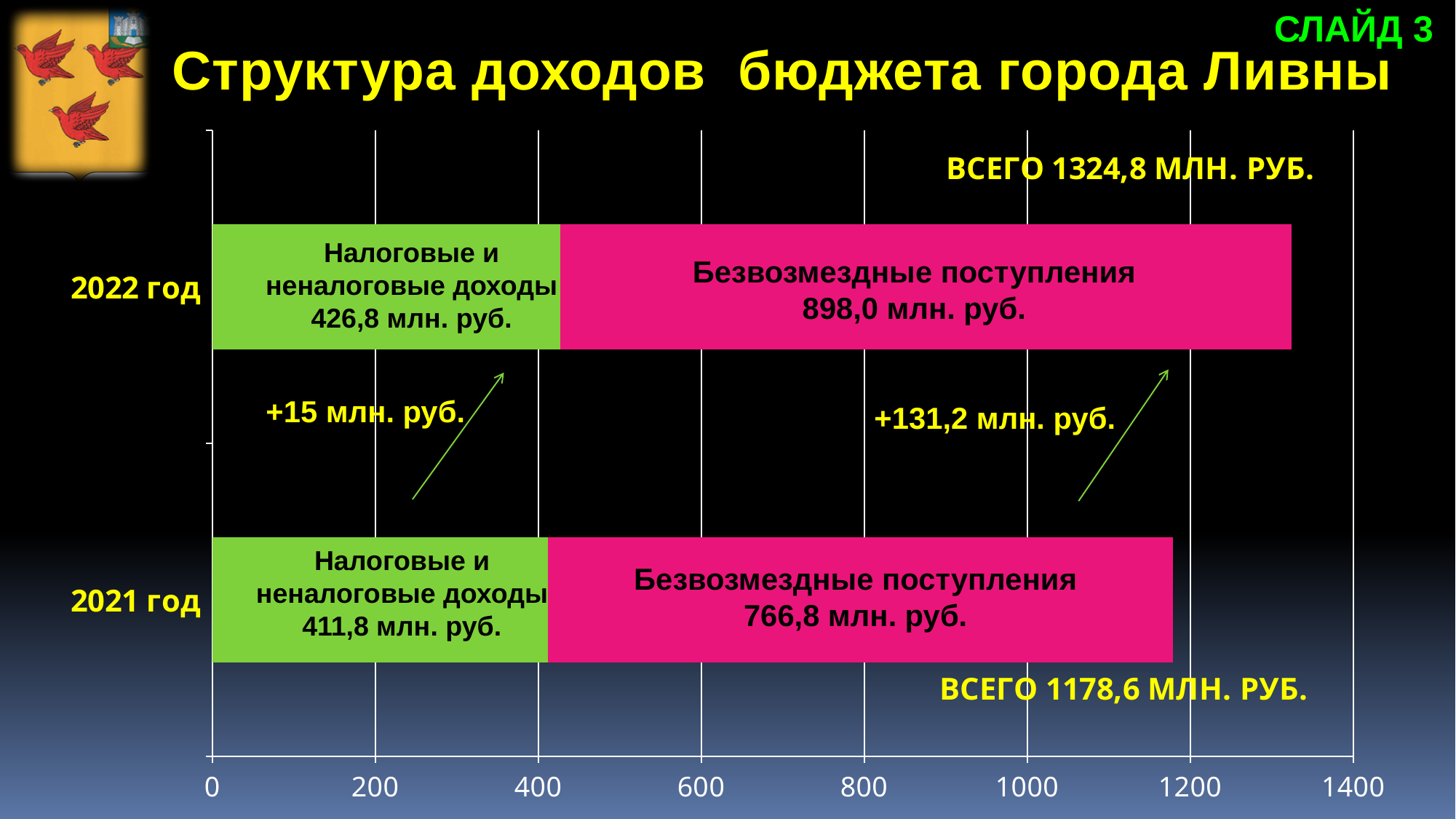
What kind of chart is shown on the slide? Stacked bar chart Which year has the larger value for Безвозмездные поступления, 2021 год or 2022 год? 2022 год What is the value of Безвозмездные поступления for 2021 год? 766,8 млн. руб. What is the value of Налоговые и неналоговые доходы for 2022 год? 426,8 млн. руб. By how much did Безвозмездные поступления change from 2021 год to 2022 год? +131,2 млн. руб. How many years (categories) are shown in the chart? 2 What is the title of the chart on the slide? Структура доходов бюджета города Ливны What is the total of the stacked bar for 2021 год? 1178,6 млн. руб. What is the total of the stacked bar for 2022 год? 1324,8 млн. руб. Which year has the higher total budget revenue? 2022 год By how much did Налоговые и неналоговые доходы change from 2021 год to 2022 год? +15 млн. руб. What is the value of Безвозмездные поступления for 2022 год? 898,0 млн. руб.